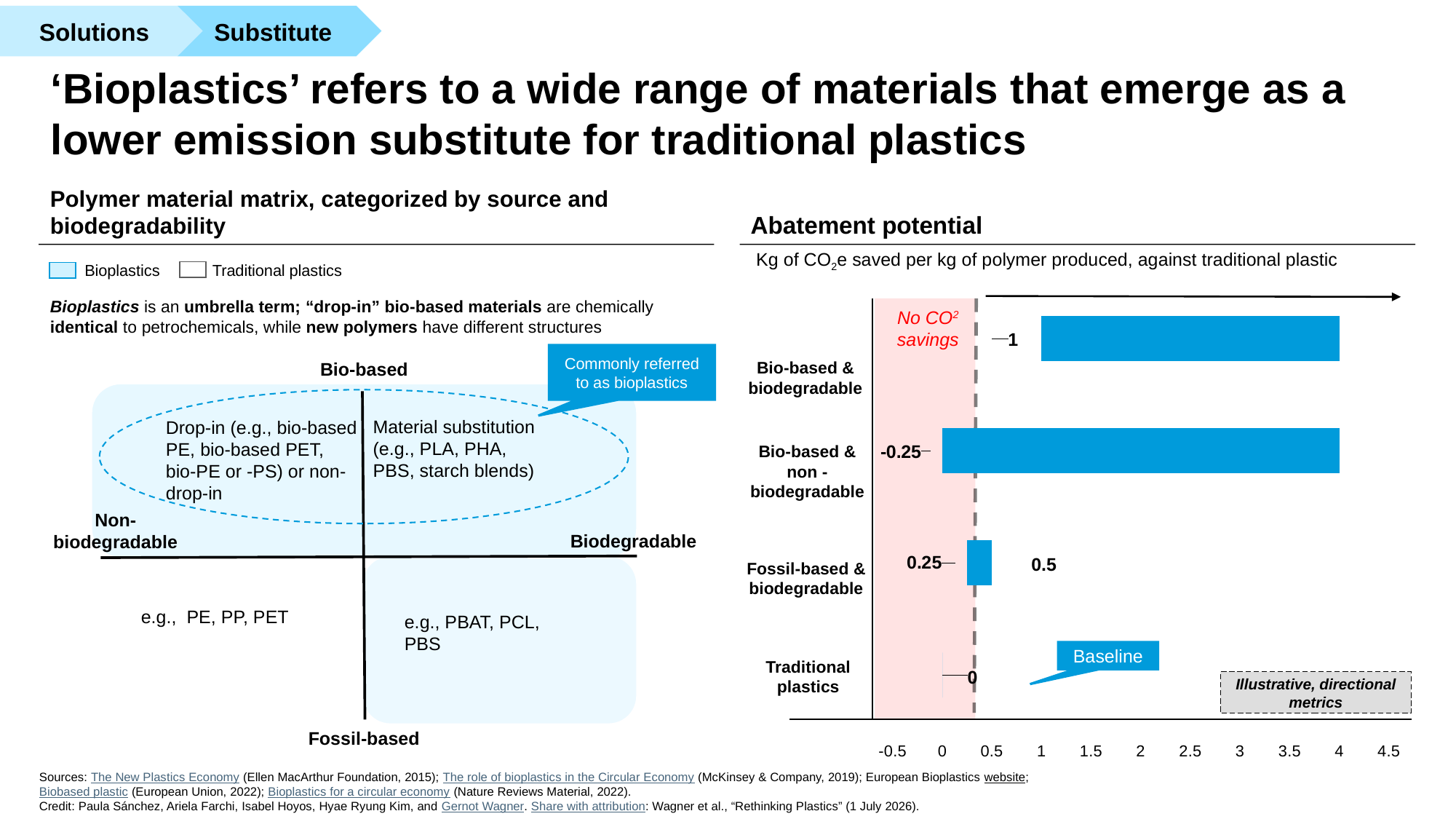
What kind of chart is the 'Abatement potential' chart? bar chart On the 'Abatement potential' chart, what value is labelled for Traditional plastics? 0 On the 'Abatement potential' chart, which has the higher lower-end value: Bio-based & biodegradable or Fossil-based & biodegradable? Bio-based & biodegradable On the 'Abatement potential' chart, what is the lower end of the range labelled for Bio-based & biodegradable? 1 On the 'Abatement potential' chart, which category is annotated as the 'Baseline'? Traditional plastics On the 'Abatement potential' chart, is the upper end of the Bio-based & biodegradable bar greater or less than 3? greater On the 'Abatement potential' chart, what is the lower end of the range labelled for Bio-based & non-biodegradable? -0.25 How many polymer categories are shown on the 'Abatement potential' chart? 4 What unit is stated under the 'Abatement potential' title? Kg of CO2e saved per kg of polymer produced, against traditional plastic On the 'Abatement potential' chart, what is the difference between the lower end for Bio-based & biodegradable (1) and the lower end for Fossil-based & biodegradable (0.25)? 0.75 On the 'Abatement potential' chart, what is the upper end of the range labelled for Fossil-based & biodegradable? 0.5 On the 'Abatement potential' chart, which category has the lowest labelled value? Bio-based & non-biodegradable